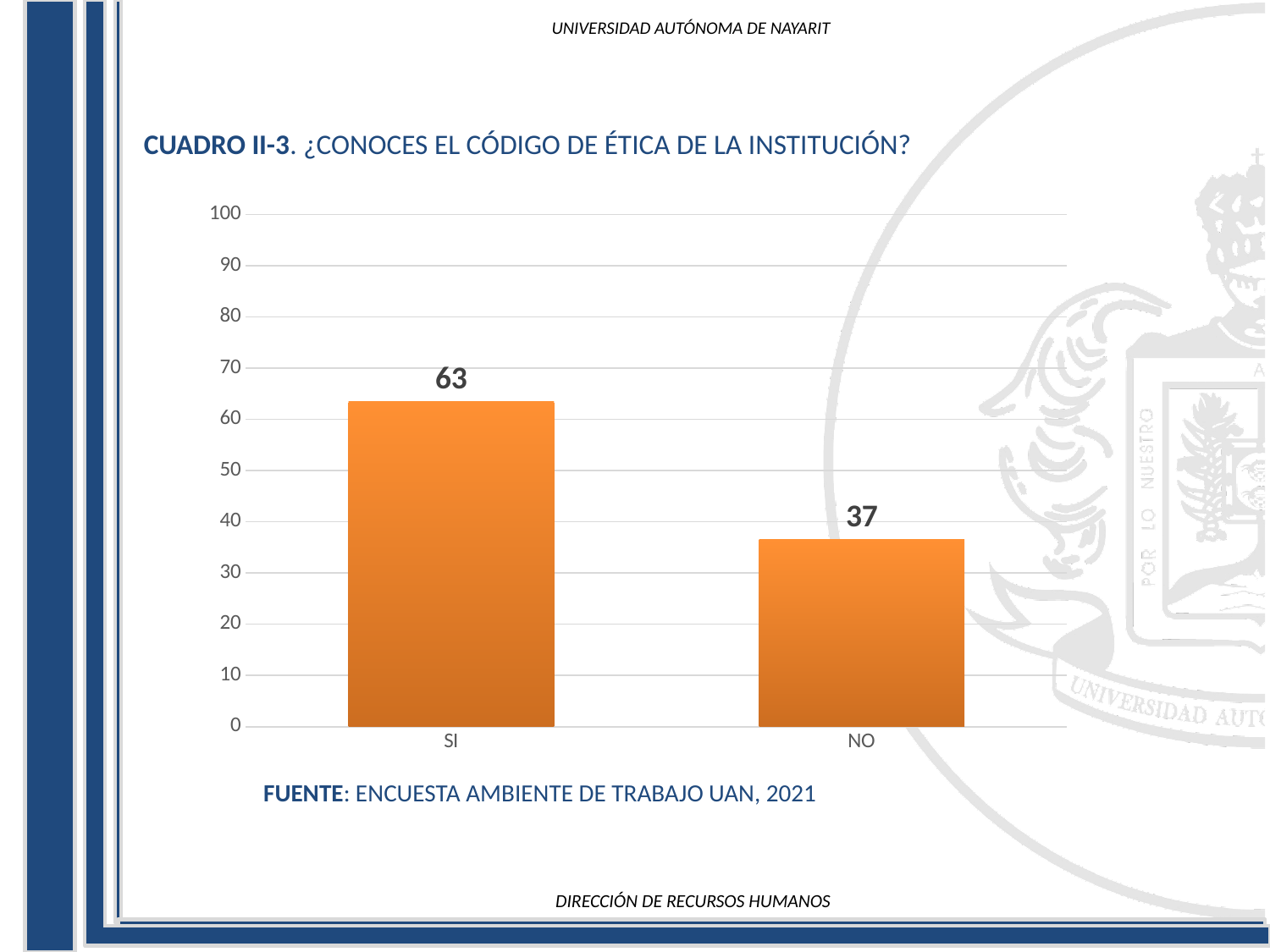
Is the value for NO greater or less than 40? less How many categories are shown on the x axis? 2 What is the value for NO? 37 What is the source cited below the chart? ENCUESTA AMBIENTE DE TRABAJO UAN, 2021 Which category has the highest value? SI Which is larger, the value for SI or the value for NO? SI What is the value for SI? 63 Which category has the lowest value? NO What is the difference between the values for SI and NO? 26 What is the total of the values for SI and NO? 100 What kind of chart is shown on the slide? bar chart Is the value for SI greater or less than 60? greater